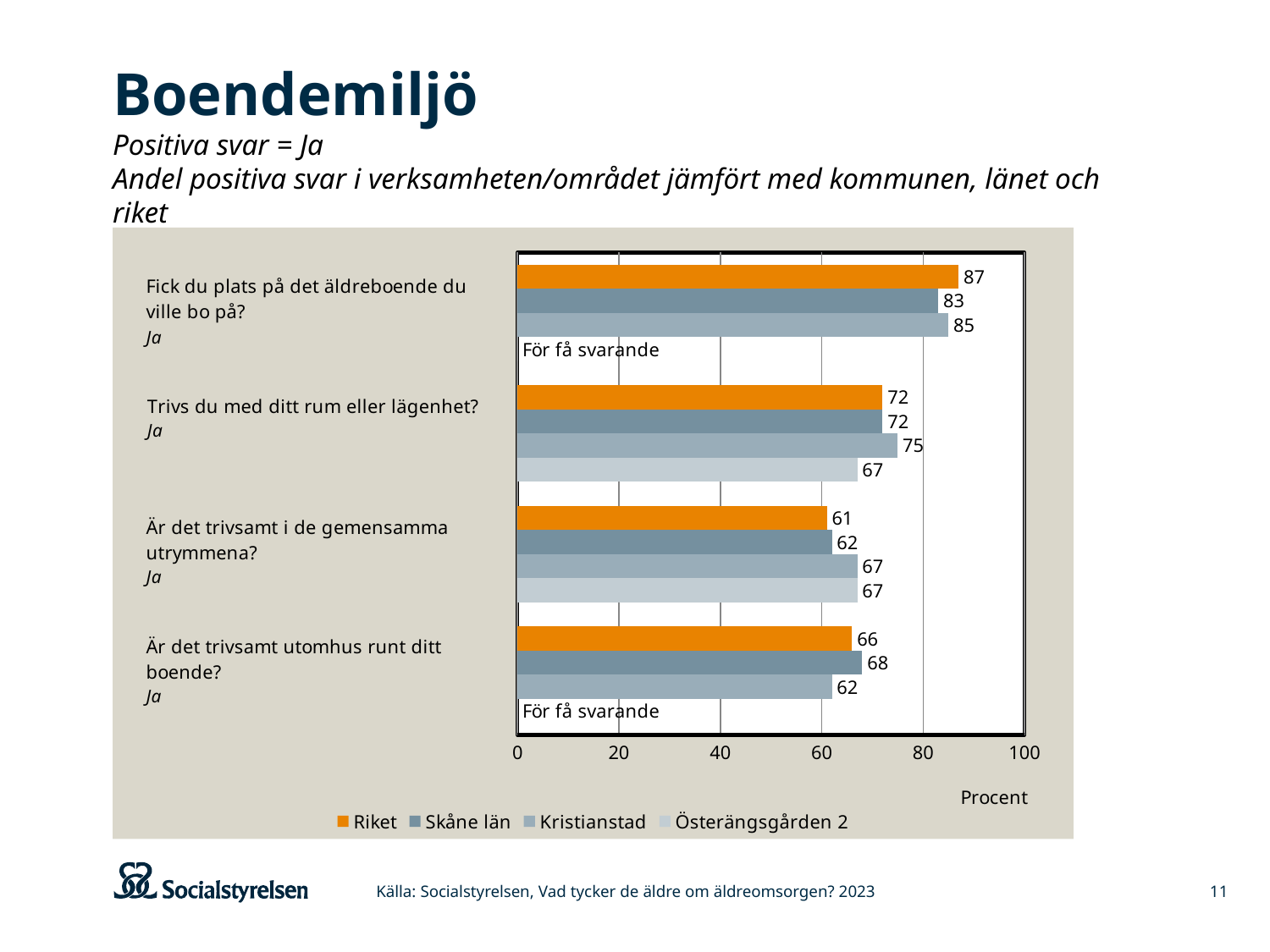
What is shown for Österängsgården 2 on "Fick du plats på det äldreboende du ville bo på?"? För få svarande What is the value for Skåne län on "Är det trivsamt utomhus runt ditt boende?"? 68 What is the difference between Kristianstad and Österängsgården 2 on "Trivs du med ditt rum eller lägenhet?"? 8 Which series has the lowest value on "Är det trivsamt utomhus runt ditt boende?"? Kristianstad How many question categories are shown on the chart? 4 What is the value for Kristianstad on "Är det trivsamt i de gemensamma utrymmena?"? 67 What is the value for Riket on "Fick du plats på det äldreboende du ville bo på?"? 87 Which series has the highest value on "Fick du plats på det äldreboende du ville bo på?"? Riket On "Är det trivsamt i de gemensamma utrymmena?", which is larger: Riket or Kristianstad? Kristianstad How many series does the legend list? 4 What kind of chart is shown on the slide? Bar chart What is the value for Österängsgården 2 on "Trivs du med ditt rum eller lägenhet?"? 67